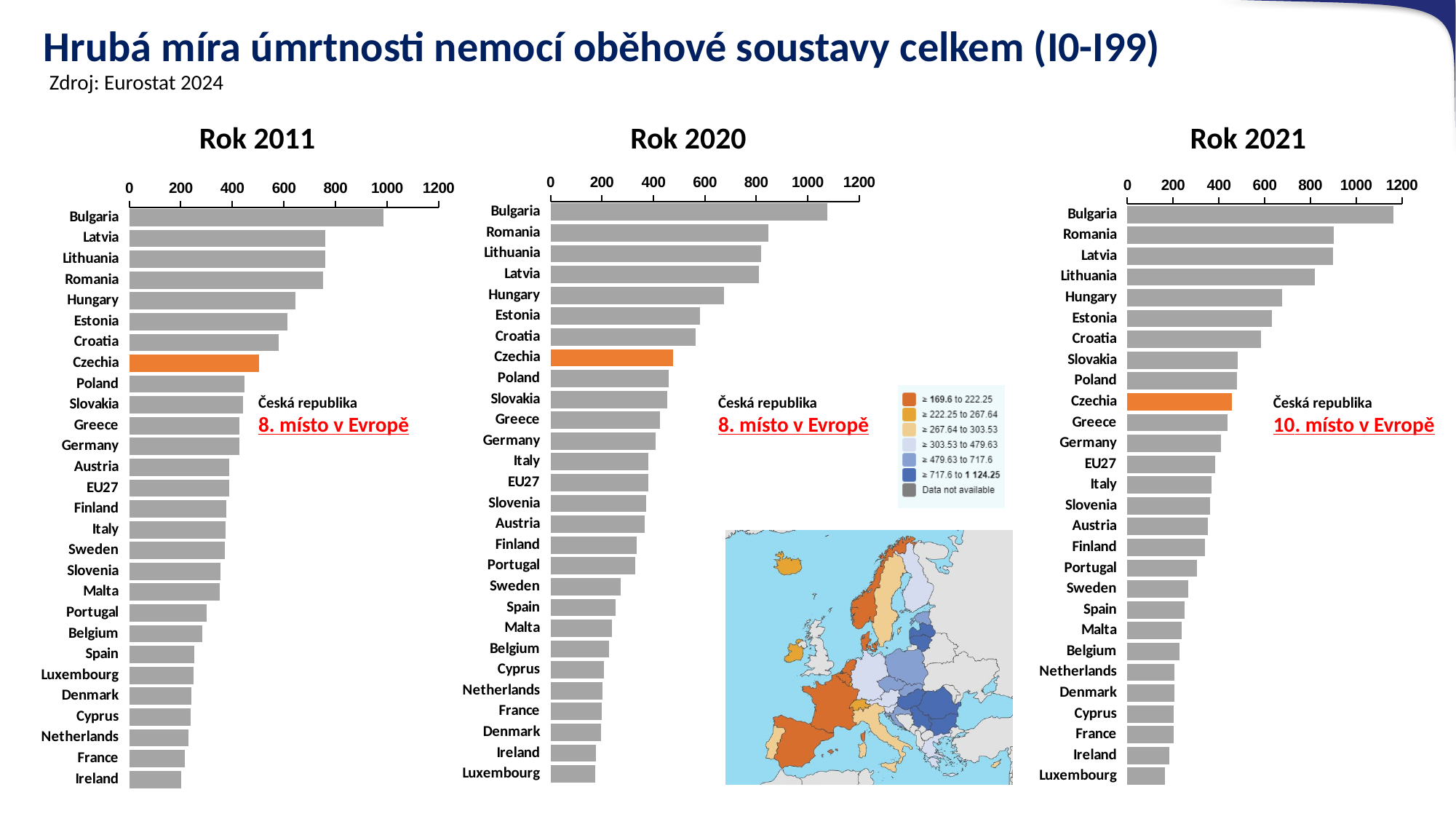
In the 'Rok 2020' chart, is the value for Bulgaria greater or less than 1000? greater In the 'Rok 2020' chart, is the value for Hungary greater or less than 600? greater In the 'Rok 2020' chart, which is larger, the value for Bulgaria or the value for Czechia? Bulgaria In the 'Rok 2021' chart, which country's bar is highlighted in orange? Czechia How many categories (bars) are shown in the 'Rok 2011' chart? 28 In the 'Rok 2011' chart, is the value for Bulgaria greater or less than 800? greater In the 'Rok 2021' chart, which country has the highest value? Bulgaria What kind of chart is the 'Rok 2011' chart? bar chart In the 'Rok 2011' chart, which country has the highest value? Bulgaria In the 'Rok 2021' chart, which is larger, the value for Romania or the value for Greece? Romania In the 'Rok 2020' chart, which country has the highest value? Bulgaria